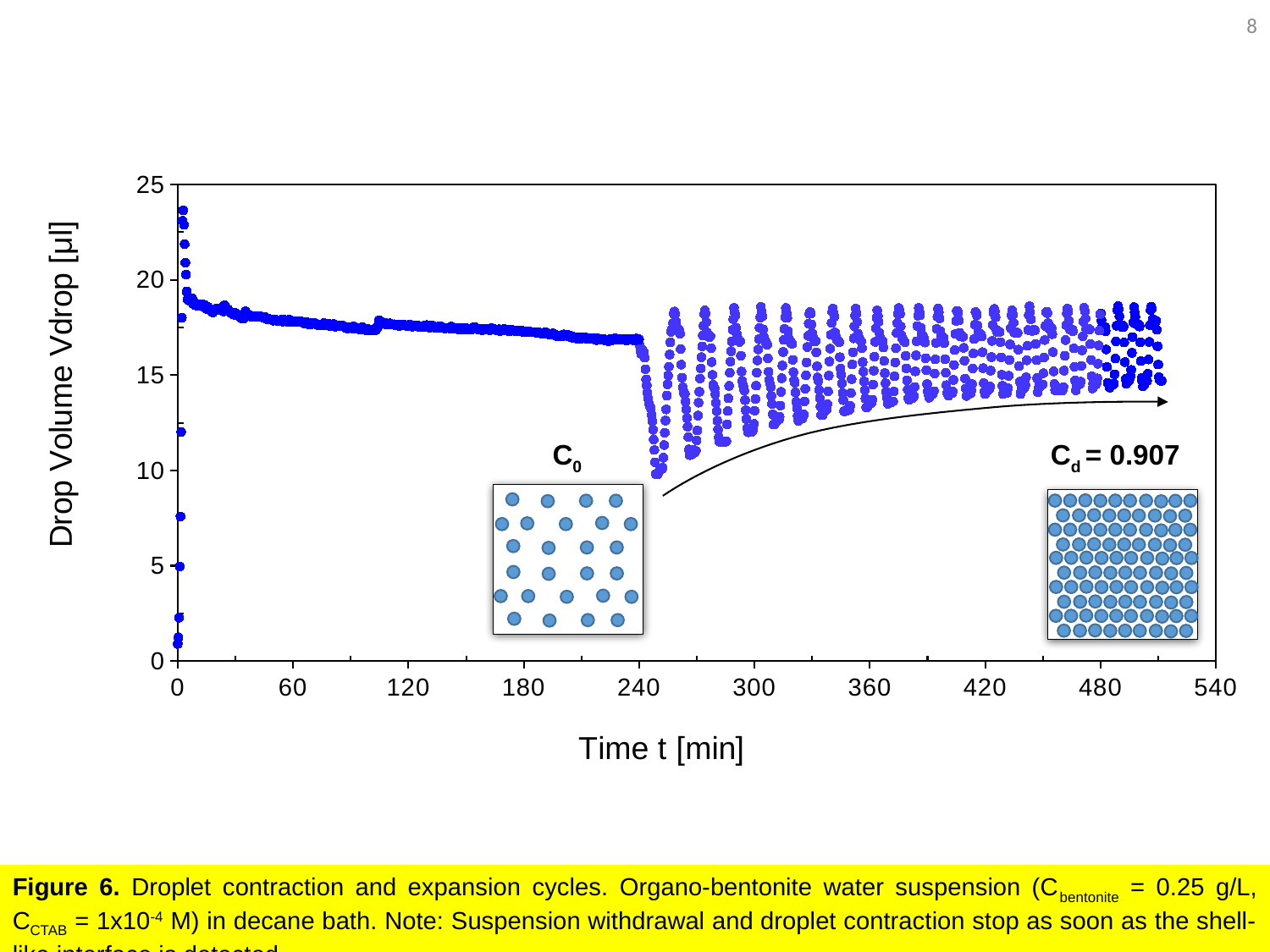
Is the time at which the oscillations begin greater or less than 180 min? greater Between 60 min and 240 min, does the drop volume rise or fall along the x axis? fall Is the highest plotted drop volume greater or less than 20? greater Is the drop volume at 120 min greater or less than 15? greater What is the label of the y axis? Drop Volume Vdrop [µl] After the oscillations begin, do the lower minima of the cycles rise or fall over time? rise What kind of chart is shown on the slide? scatter plot What is the label of the x axis? Time t [min] What is the largest tick value shown on the x axis? 540